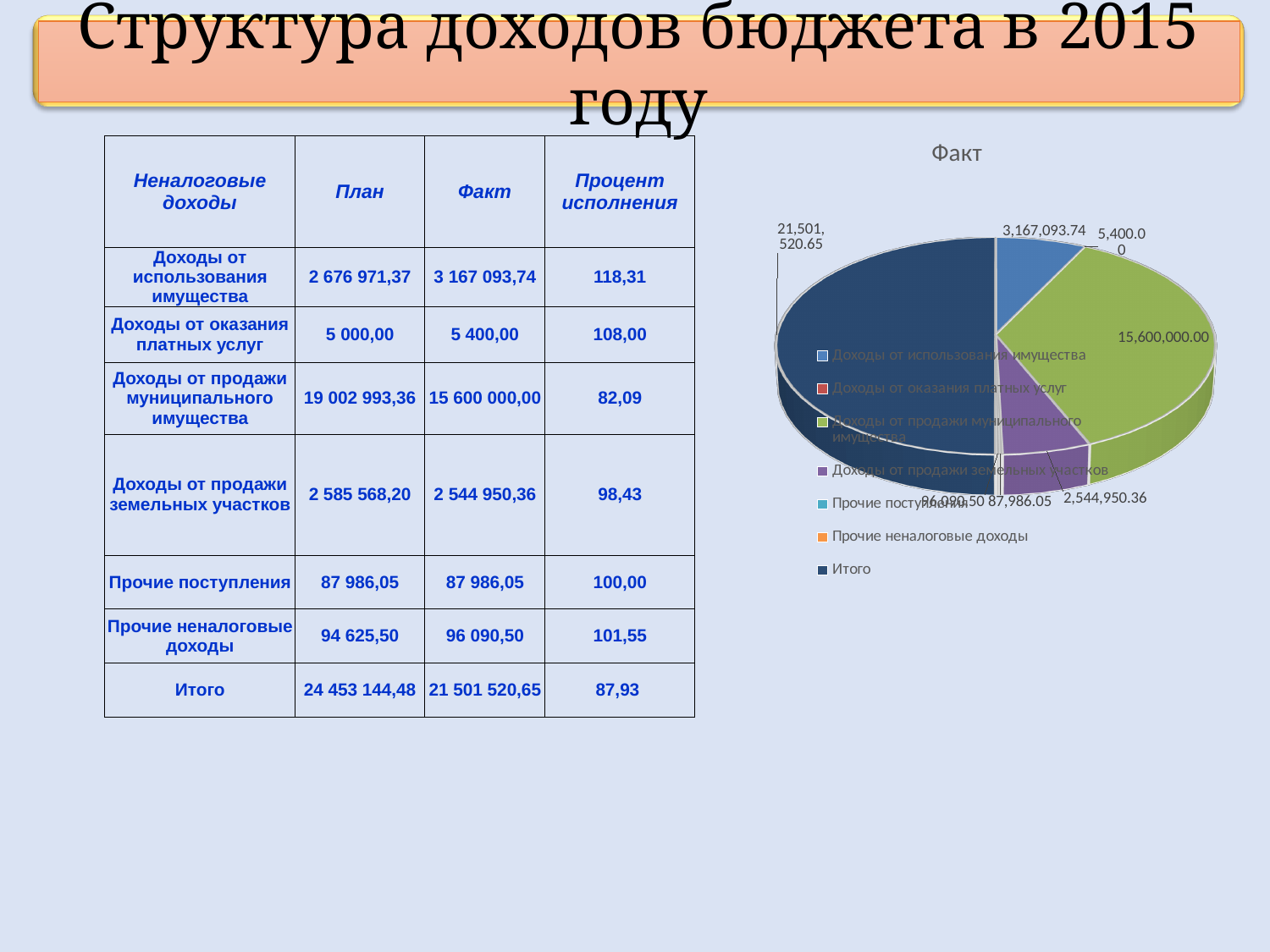
What is the title of the chart on the slide? Факт What value is labelled on the chart for Итого? 21,501,520.65 What kind of chart is shown on the slide? pie chart What value is labelled on the chart for Доходы от продажи муниципального имущества? 15,600,000.00 Which slice of the pie chart is the largest? Итого Which legend entry has the smallest labelled value on the chart? Доходы от оказания платных услуг What colour is the Итого slice in the pie chart? dark blue What value is labelled on the chart for Доходы от использования имущества? 3,167,093.74 What value is labelled on the chart for Доходы от продажи земельных участков? 2,544,950.36 Which is larger on the chart: Доходы от использования имущества or Доходы от продажи земельных участков? Доходы от использования имущества What is the difference between the labelled values for Доходы от продажи муниципального имущества and Доходы от использования имущества? 12,432,906.26 How many entries does the chart's legend list? 7